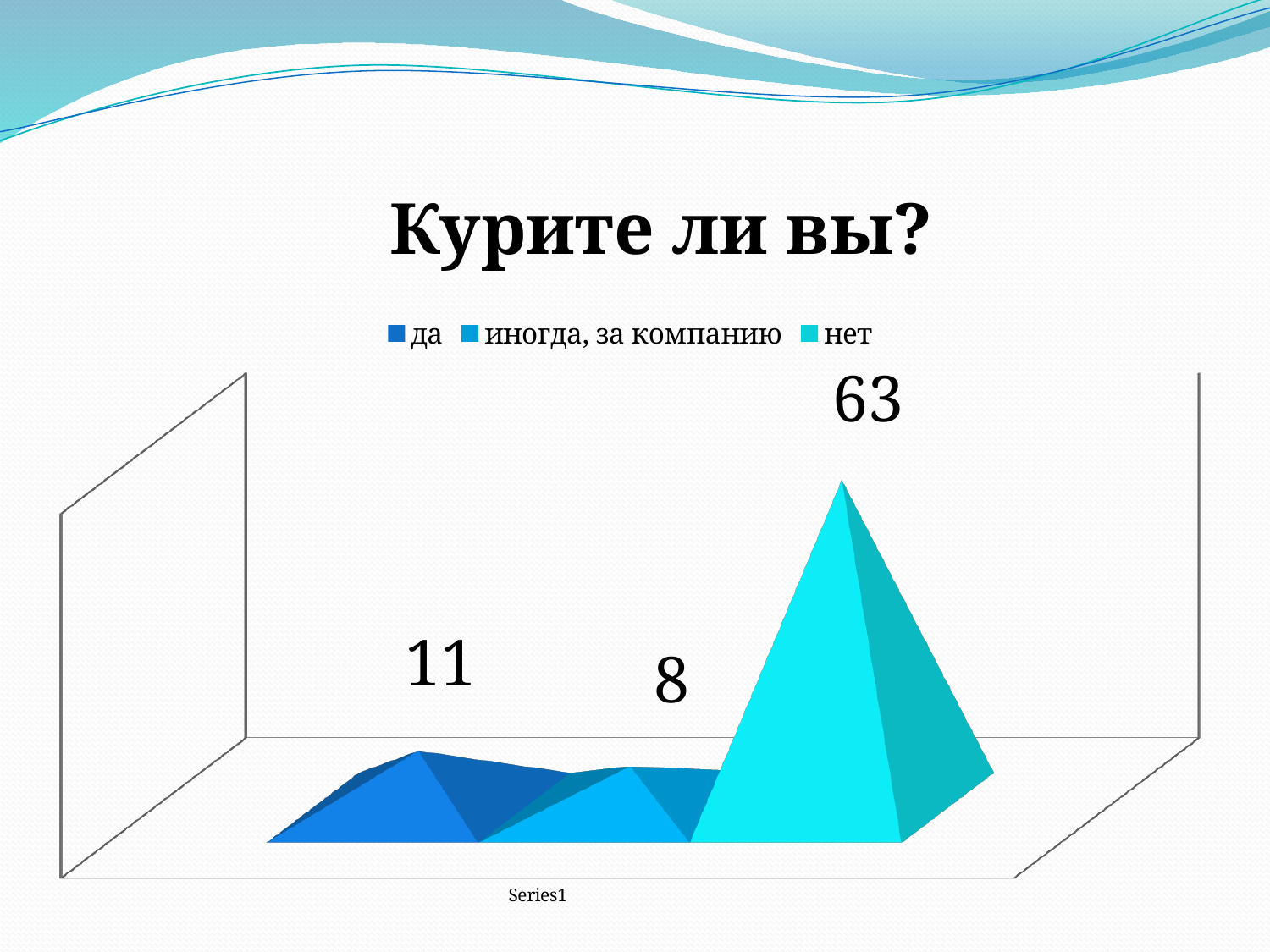
How many categories are plotted in the chart? 3 How many entries does the legend list? 3 What is the value for "да"? 11 What kind of chart is shown on the slide? bar chart What is the difference between the values for "да" and "иногда, за компанию"? 3 What is the difference between the values for "нет" and "да"? 52 Which is larger, the value for "да" or the value for "иногда, за компанию"? да What is the title of the chart? Курите ли вы? What is the value for "иногда, за компанию"? 8 Which category has the highest value? нет Which category has the lowest value? иногда, за компанию What is the value for "нет"? 63